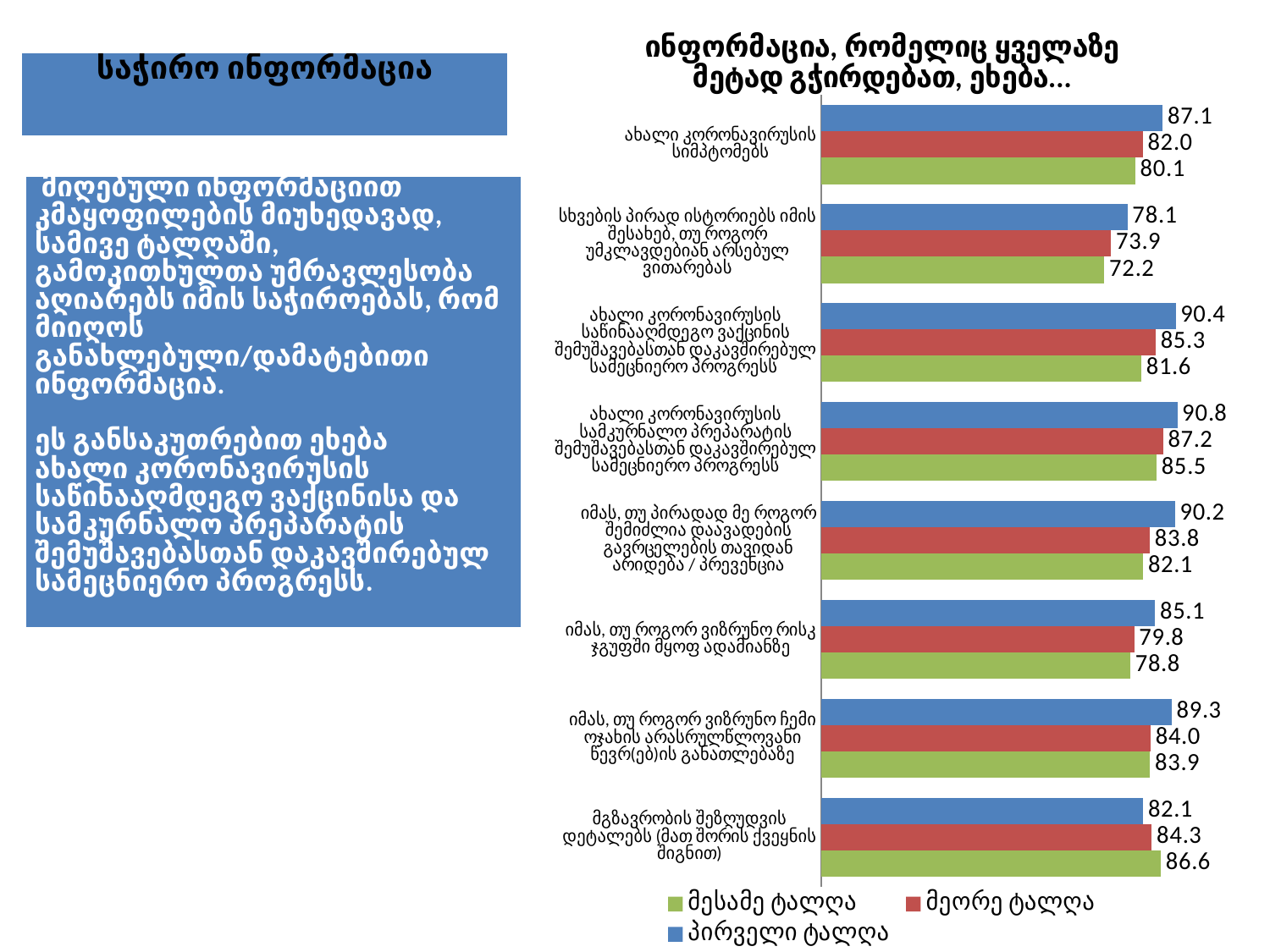
How many categories are plotted on the chart? 8 What type of chart is shown on the slide? bar chart Which category has the lowest value in the "მესამე ტალღა" series? სხვების პირად ისტორიებს იმის შესახებ, თუ როგორ უმკლავდებიან არსებულ ვითარებას Which series is shown in green on the chart? მესამე ტალღა For "მგზავრობის შეზღუდვის დეტალებს (მათ შორის ქვეყნის შიგნით)", which series has the larger value: "პირველი ტალღა" or "მესამე ტალღა"? მესამე ტალღა What is the title of the chart? ინფორმაცია, რომელიც ყველაზე მეტად გჭირდებათ, ეხება... Which category has the highest value in the "პირველი ტალღა" series? ახალი კორონავირუსის სამკურნალო პრეპარატის შემუშავებასთან დაკავშირებულ სამეცნიერო პროგრესს What is the difference between the "პირველი ტალღა" and "მესამე ტალღა" values for "ახალი კორონავირუსის საწინააღმდეგო ვაქცინის შემუშავებასთან დაკავშირებულ სამეცნიერო პროგრესს"? 8.8 How many series does the chart legend list? 3 What is the value of the "პირველი ტალღა" series for "ახალი კორონავირუსის სიმპტომებს"? 87.1 What is the value of the "მესამე ტალღა" series for "მგზავრობის შეზღუდვის დეტალებს (მათ შორის ქვეყნის შიგნით)"? 86.6 What is the value of the "მეორე ტალღა" series for "იმას, თუ როგორ ვიზრუნო რისკ ჯგუფში მყოფ ადამიანზე"? 79.8